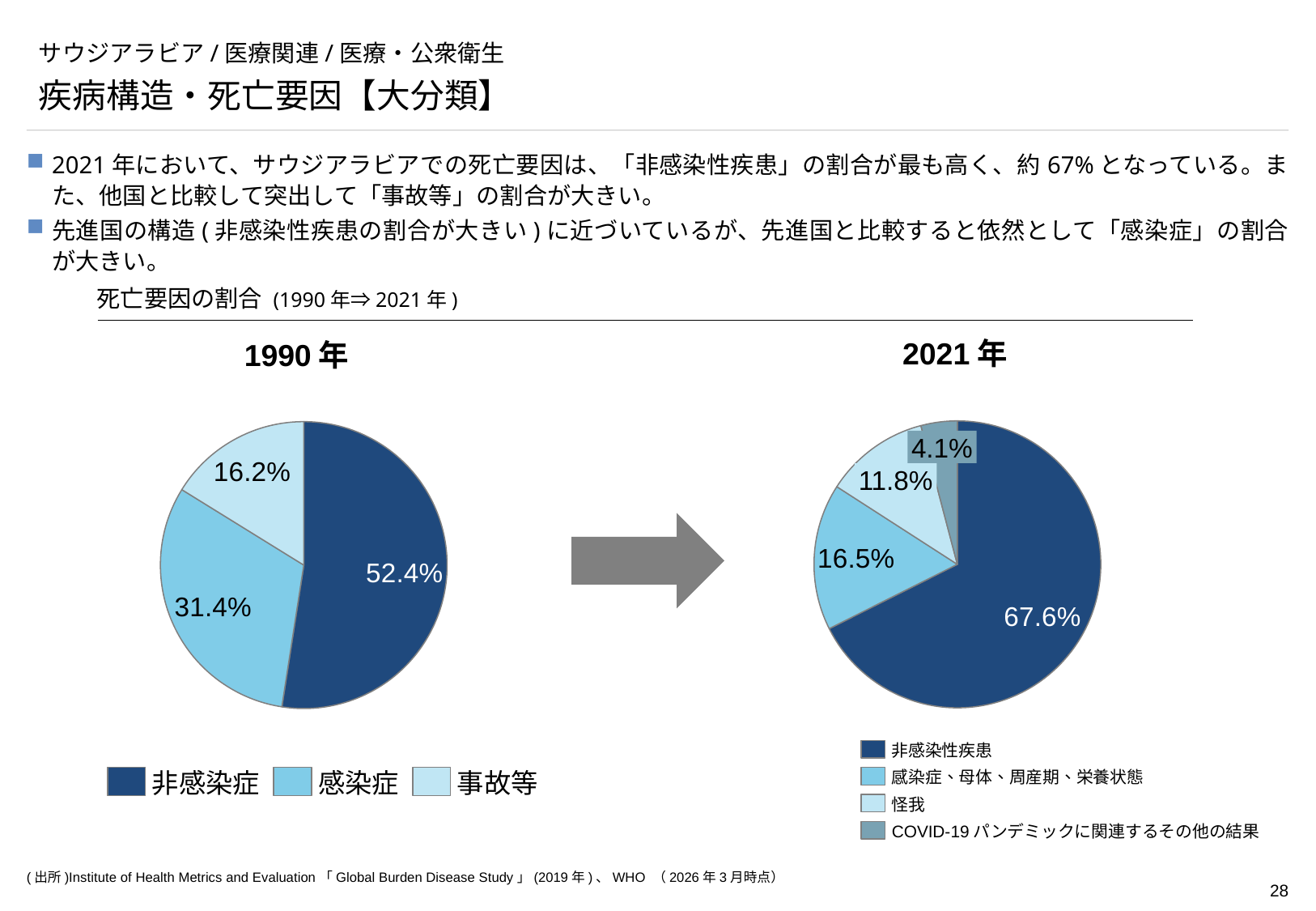
In the 1990年 pie chart, what is the share for 感染症? 31.4% In the 1990年 pie chart, what is the share for 事故等? 16.2% What type of chart is used to show the 1990年 data? Pie chart In the 2021年 pie chart, which category has the smallest share? COVID-19 パンデミックに関連するその他の結果 In the 1990年 pie chart, what is the share for 非感染症? 52.4% In the 1990年 pie chart, which category has the largest share? 非感染症 In the 2021年 pie chart, what is the share for 非感染性疾患? 67.6% In the 2021年 pie chart, what is the share for COVID-19 パンデミックに関連するその他の結果? 4.1% How many categories does the legend of the 2021年 pie chart list? 4 In the 2021年 pie chart, which is larger: the share for 感染症、母体、周産期、栄養状態 or the share for 怪我? 感染症、母体、周産期、栄養状態 What is the difference between the 非感染性疾患 share in the 2021年 chart and the 非感染症 share in the 1990年 chart? 15.2 percentage points In the 2021年 pie chart, what is the share for 怪我? 11.8%